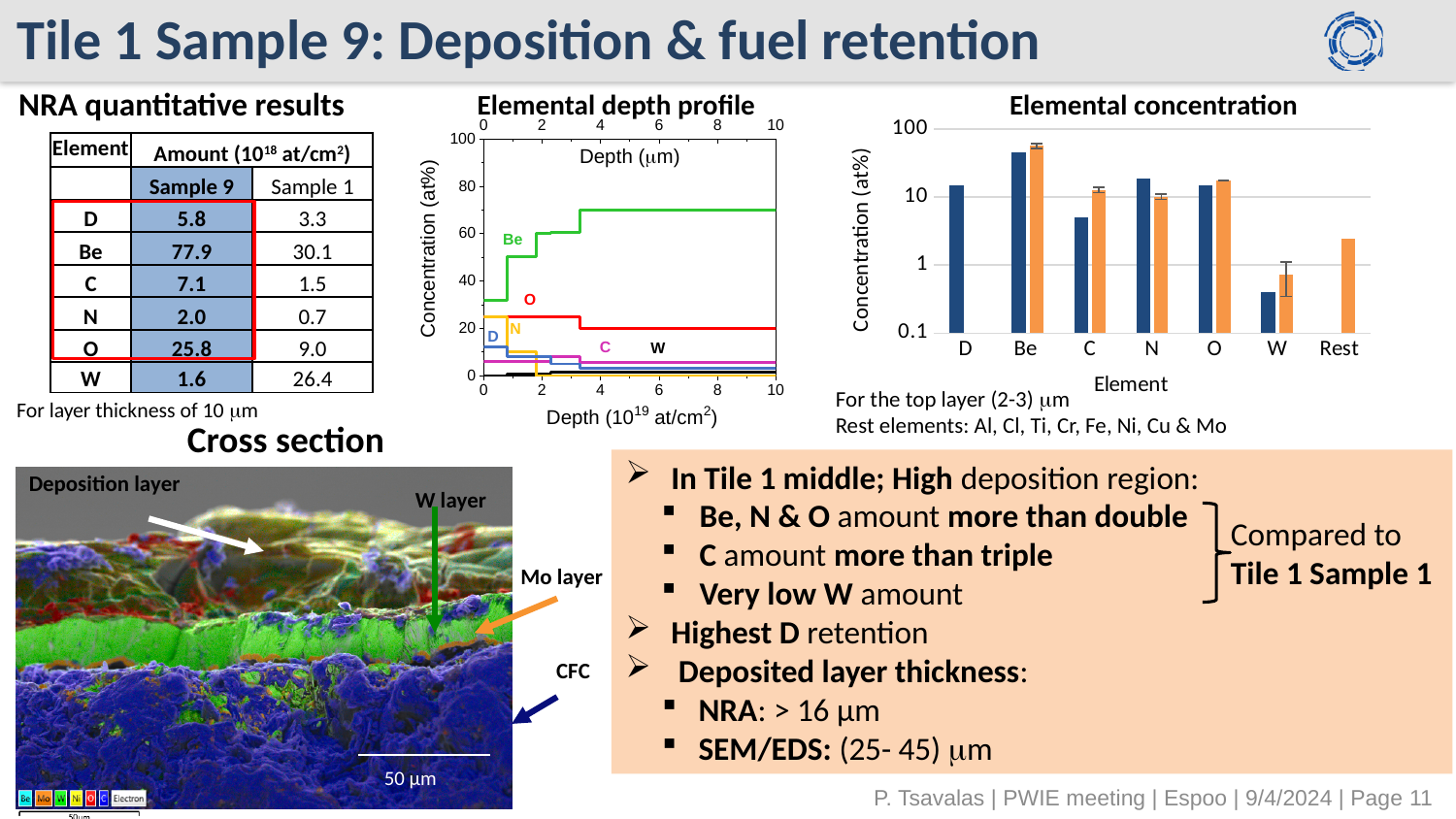
In the "Elemental depth profile" chart, does the Be line rise or fall with increasing depth? rise In the "Elemental concentration" chart, which has the larger concentration, Be or C? Be What is the y-axis label of the "Elemental depth profile" chart? Concentration (at%) What kind of chart is the "Elemental concentration" chart? bar chart In the "Elemental concentration" chart, which element has the highest concentration? Be In the "Elemental concentration" chart, is the blue bar for C greater or less than 10? less What kind of chart is the "Elemental depth profile" chart? line chart In the "Elemental concentration" chart, which element has the lowest concentration? W In the "Elemental depth profile" chart, which element line has the highest concentration? Be In the "Elemental concentration" chart, is the blue bar for W greater or less than 1? less In the "Elemental concentration" chart, how many element categories are shown on the x axis? 7 In the "Elemental concentration" chart, is the blue bar for Be greater or less than 10? greater